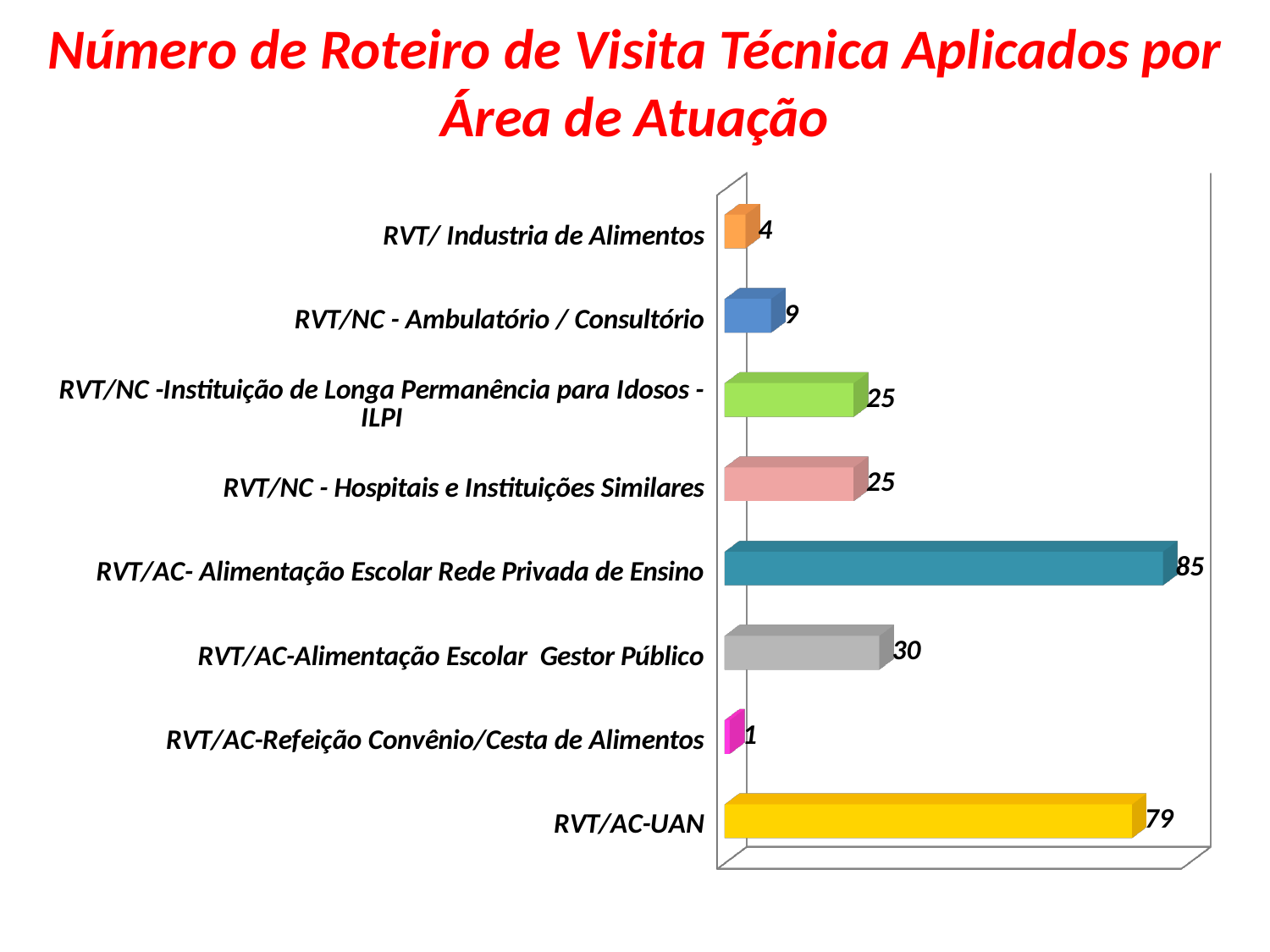
What is the value for RVT/NC - Ambulatório / Consultório? 9 Which category has the highest value? RVT/AC- Alimentação Escolar Rede Privada de Ensino What is the difference between the values for RVT/AC-Alimentação Escolar Gestor Público and RVT/NC - Hospitais e Instituições Similares? 5 What is the value for RVT/AC-UAN? 79 Which is larger, the value for RVT/ Industria de Alimentos or the value for RVT/NC - Ambulatório / Consultório? RVT/NC - Ambulatório / Consultório What is the value for RVT/AC- Alimentação Escolar Rede Privada de Ensino? 85 How many categories are shown in the chart? 8 What is the title of the chart? Número de Roteiro de Visita Técnica Aplicados por Área de Atuação Which category has the lowest value? RVT/AC-Refeição Convênio/Cesta de Alimentos What is the value for RVT/AC-Alimentação Escolar Gestor Público? 30 What is the difference between the values for RVT/AC- Alimentação Escolar Rede Privada de Ensino and RVT/AC-UAN? 6 What kind of chart is shown on the slide? Bar chart